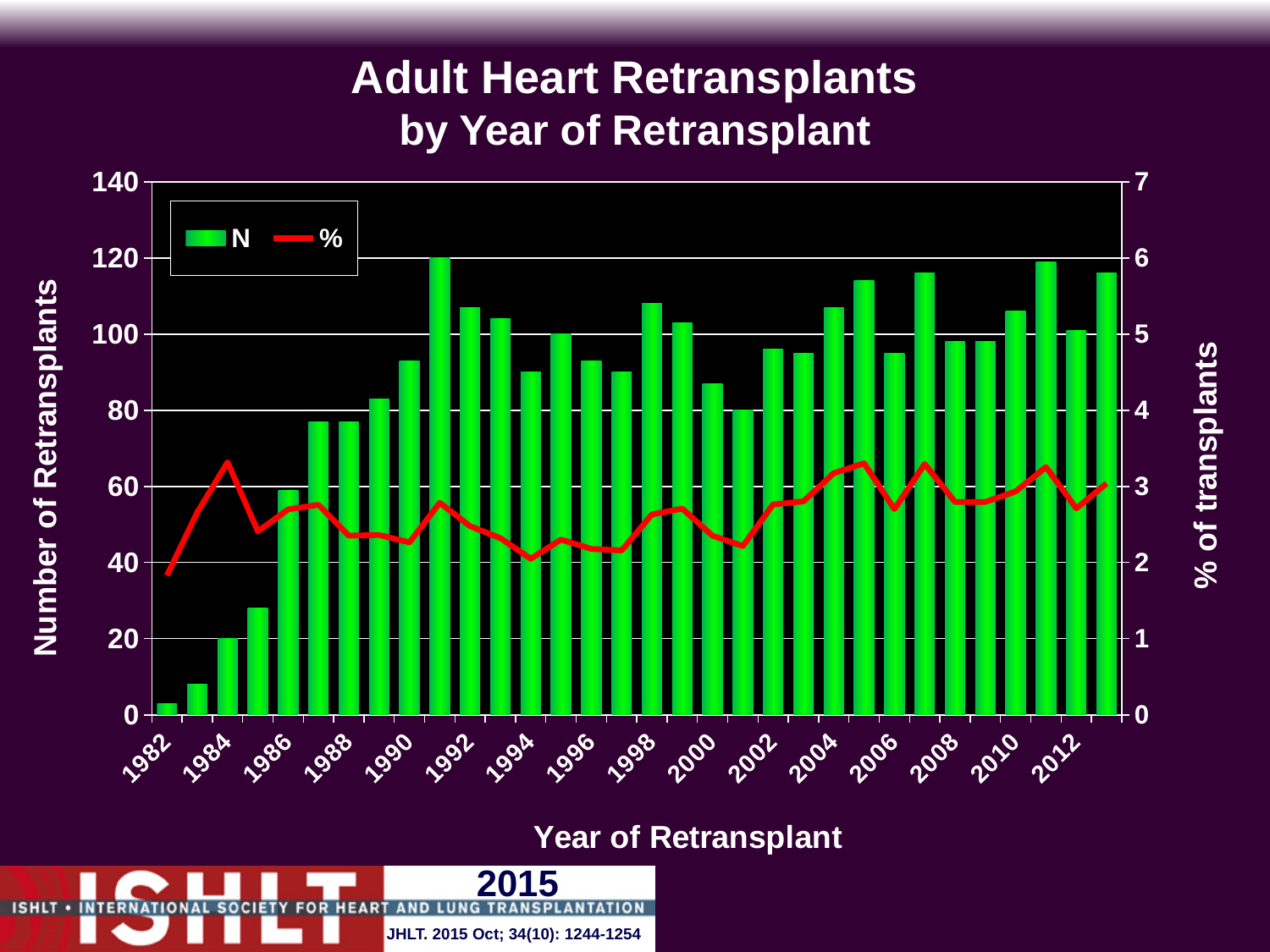
What is the title of the left vertical axis? Number of Retransplants Which year has more retransplants, 2001 or 2002? 2002 Do the number of retransplants rise or fall from 1982 to 1991? rise Is the % of transplants value for 1984 greater or less than 3? greater What are the two series named in the legend? N and % How many series does the legend list? 2 Is the number of retransplants for 1982 greater or less than 20? less Is the number of retransplants for 1990 greater or less than 80? greater Which year has the lowest number of retransplants? 1982